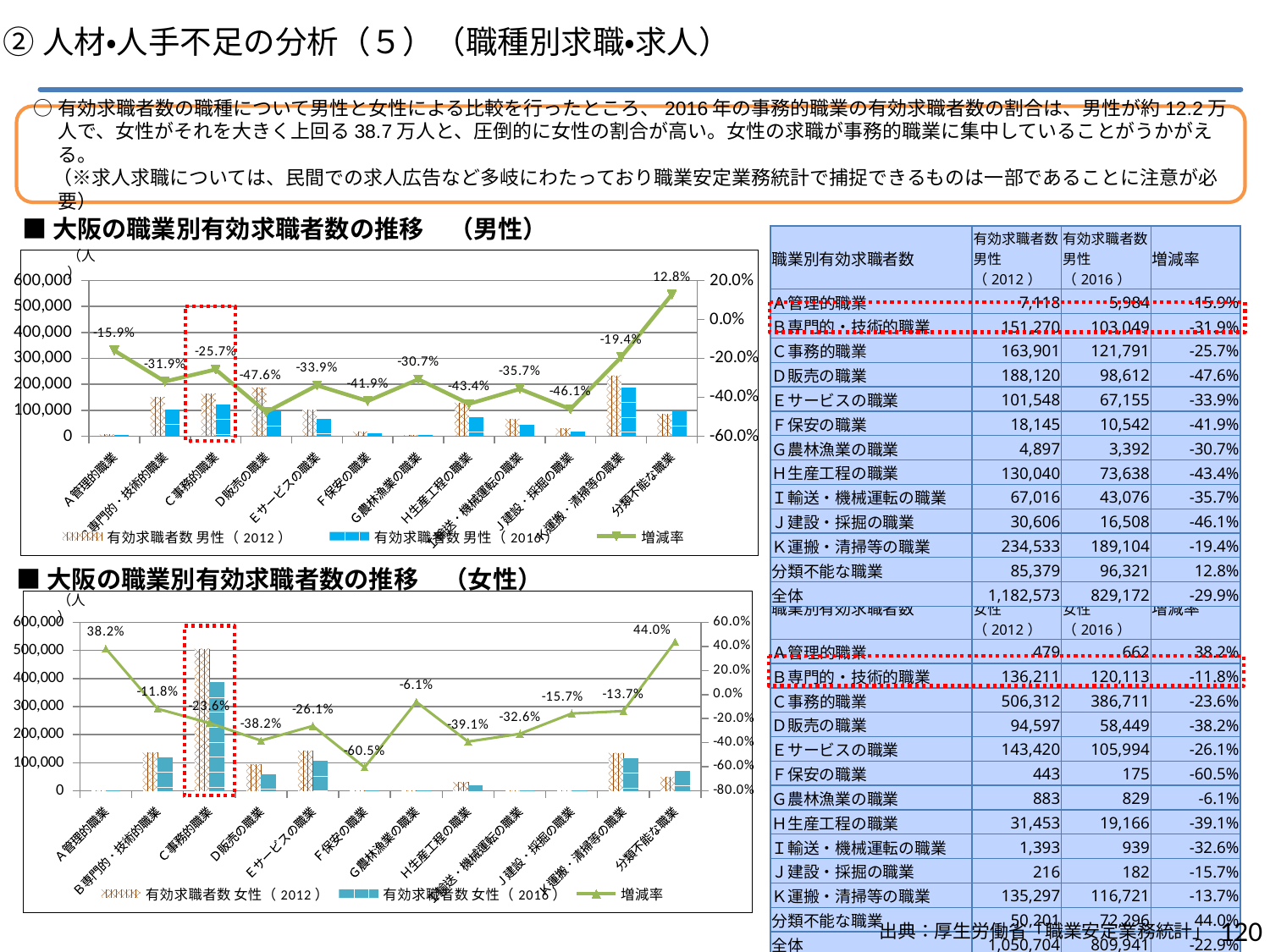
In the female chart, is the 2012 value for C事務的職業 greater or less than 400,000? greater In the male chart (大阪の職業別有効求職者数の推移（男性）), what is the 増減率 shown for D販売の職業? -47.6% In the male chart, which occupation category has the lowest 増減率? D販売の職業 In the female chart, which occupation category has the lowest 増減率? F保安の職業 In the male chart, which has the larger 増減率: H生産工程の職業 or I輸送・機械運転の職業? I輸送・機械運転の職業 In the female chart (大阪の職業別有効求職者数の推移（女性）), what is the 増減率 shown for F保安の職業? -60.5% In the female chart, what is the difference in percentage points between the 増減率 for 分類不能な職業 and for A管理的職業? 5.8 percentage points How many occupation categories are plotted along the x axis of the female chart? 12 In the male chart, which occupation category has the highest 増減率? 分類不能な職業 What kind of chart is the male chart (大阪の職業別有効求職者数の推移（男性）)? A bar chart with a line series How many series does the legend of the male chart list? 3 In the female chart, which occupation category has the highest 増減率? 分類不能な職業